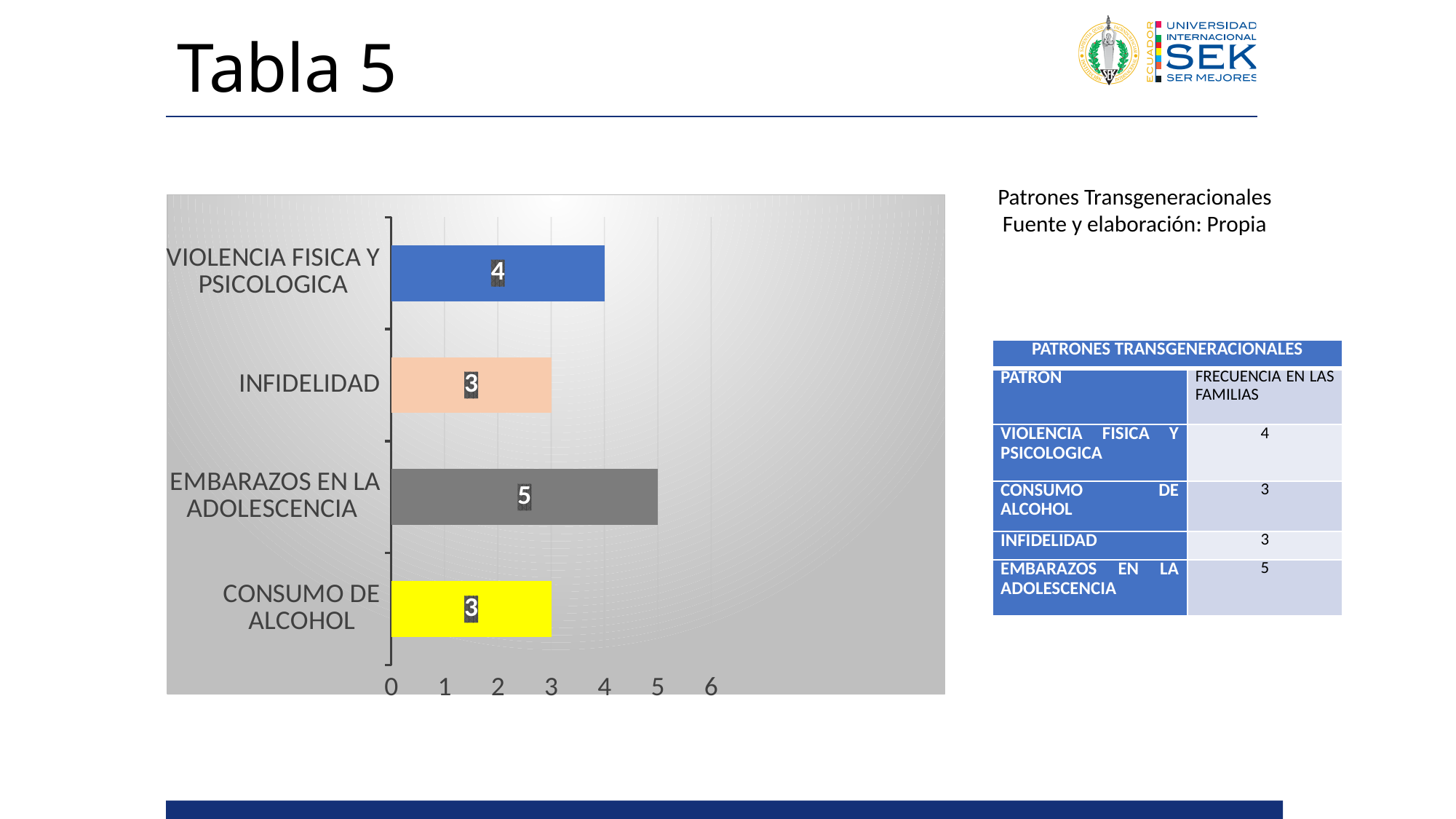
What is the value for CONSUMO DE ALCOHOL in the bar chart? 3 What is the value for VIOLENCIA FISICA Y PSICOLOGICA in the bar chart? 4 What is the difference between the values for VIOLENCIA FISICA Y PSICOLOGICA and CONSUMO DE ALCOHOL? 1 What is the value for EMBARAZOS EN LA ADOLESCENCIA in the bar chart? 5 What colour is the bar for CONSUMO DE ALCOHOL? yellow Which category has the highest value in the bar chart? EMBARAZOS EN LA ADOLESCENCIA What is the difference between the values for EMBARAZOS EN LA ADOLESCENCIA and INFIDELIDAD? 2 What kind of chart is shown on the slide? bar chart What is the value for INFIDELIDAD in the bar chart? 3 Is the value for EMBARAZOS EN LA ADOLESCENCIA greater or less than 4? greater Which is larger, the value for VIOLENCIA FISICA Y PSICOLOGICA or the value for INFIDELIDAD? VIOLENCIA FISICA Y PSICOLOGICA How many categories are shown in the bar chart? 4